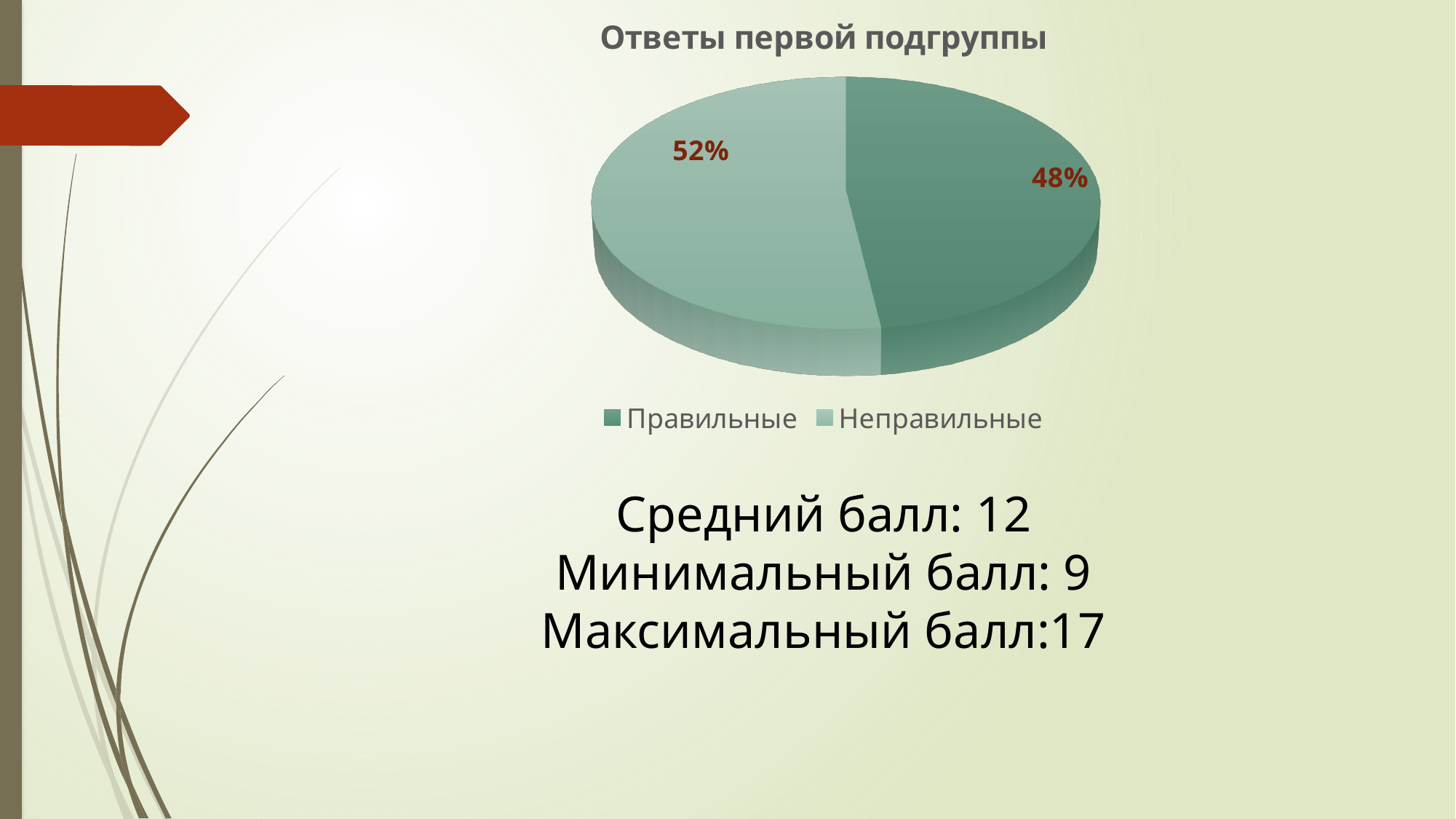
How many entries does the legend list? 2 Which category has the largest slice of the pie? Неправильные How many slices does the pie chart have? 2 What is the title of the chart? Ответы первой подгруппы Which category has the smallest slice of the pie? Правильные What kind of chart is shown on the slide? Pie chart What is the difference in percentage points between the Неправильные and Правильные slices? 4% What share of the pie does the Правильные slice take? 48% Which legend entry is shown in the darker green colour? Правильные What share of the pie does the Неправильные slice take? 52% Which is larger, the Правильные slice or the Неправильные slice? Неправильные